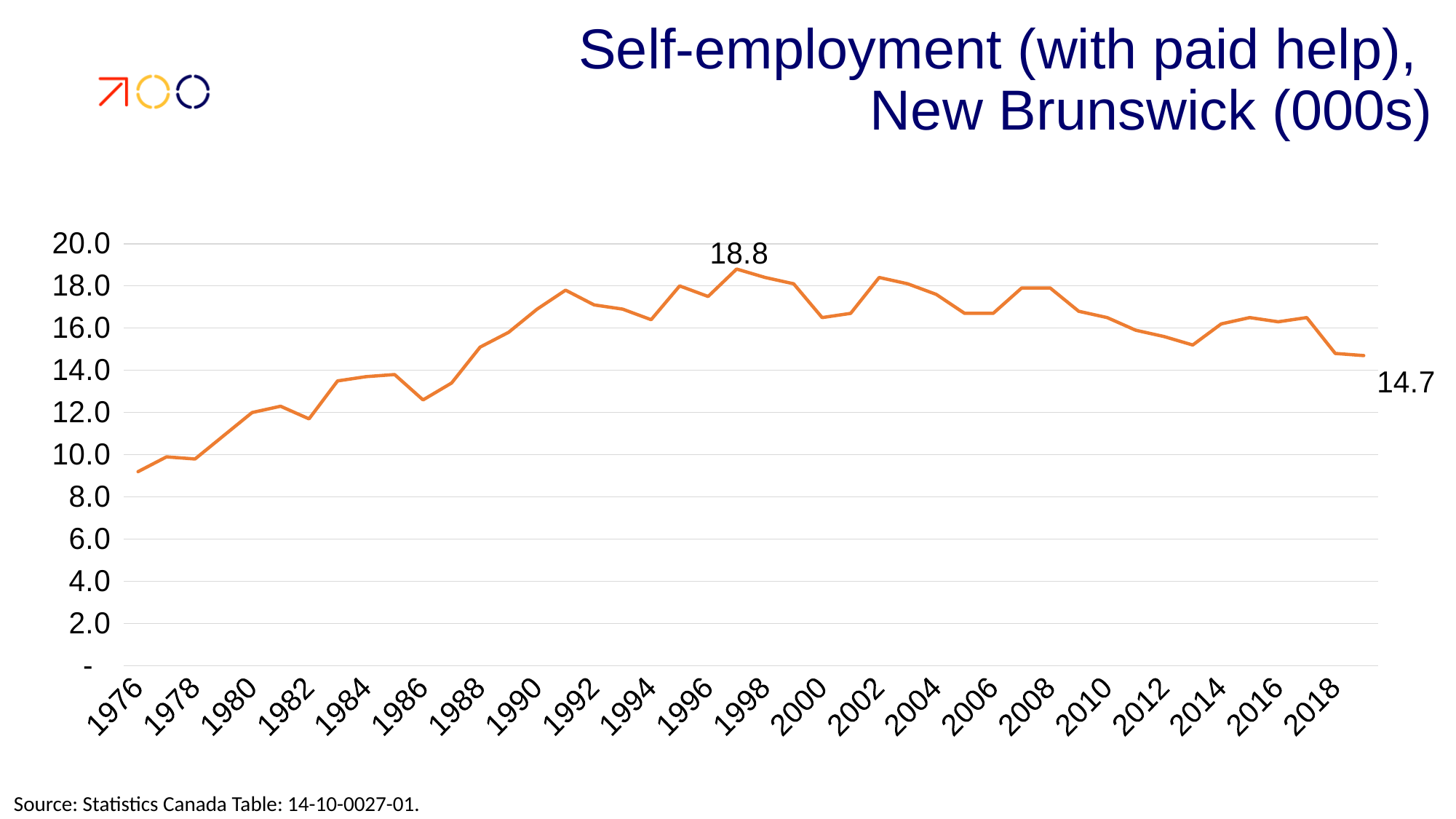
Does the line generally rise or fall between 2008 and 2018? fall What is the title of the chart? Self-employment (with paid help), New Brunswick (000s) Is the value for 2000 greater or less than 18.0? less Is the value for 1976 greater or less than 10.0? less Is the value for 1984 greater or less than 12.0? greater What is the highest value labelled on the line? 18.8 Which year has the larger value, 1976 or 1990? 1990 What is the difference between the peak value of 18.8 and the final value of 14.7? 4.1 Does the line generally rise or fall between 1976 and 1990? rise What type of chart is shown on the slide? line chart What is the value labelled at the last point of the line? 14.7